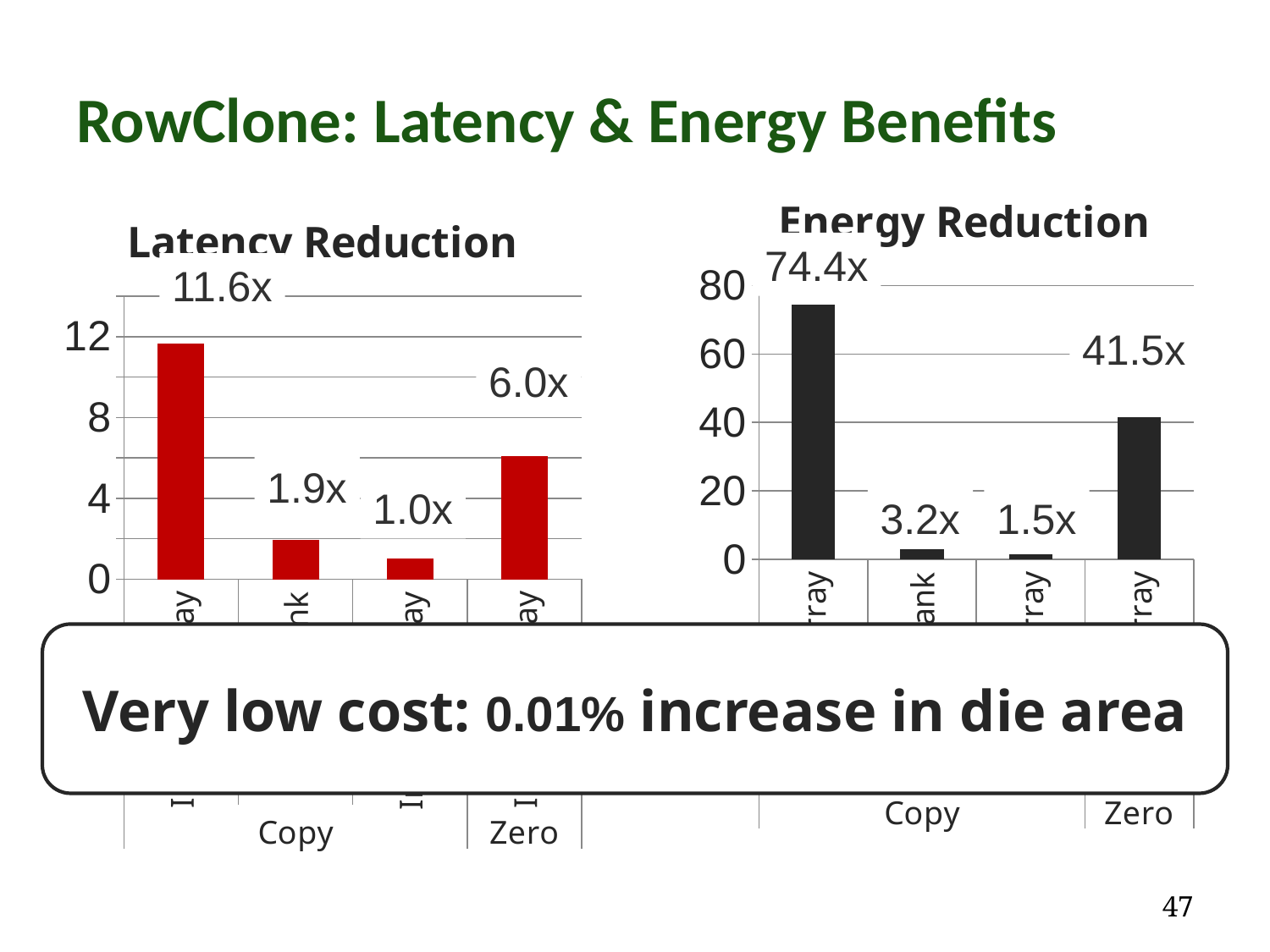
How many bars are plotted in the Latency Reduction chart? 4 What type of chart is the Latency Reduction chart? bar chart In the Energy Reduction chart, what is the difference between the highest bar and the Zero bar? 32.9x In the Latency Reduction chart, what is the value of the bar in the Zero group? 6.0x In the Latency Reduction chart, what is the highest value shown? 11.6x In the Latency Reduction chart, what is the lowest value shown? 1.0x In the Energy Reduction chart, what is the highest value shown? 74.4x In the Energy Reduction chart, what is the value of the bar in the Zero group? 41.5x In the Energy Reduction chart, what is the lowest value shown? 1.5x What colour are the bars in the Latency Reduction chart? red In the Latency Reduction chart, what is the difference between the highest bar and the Zero bar? 5.6x In the Energy Reduction chart, is the value of the first (leftmost) bar greater or less than 60? greater